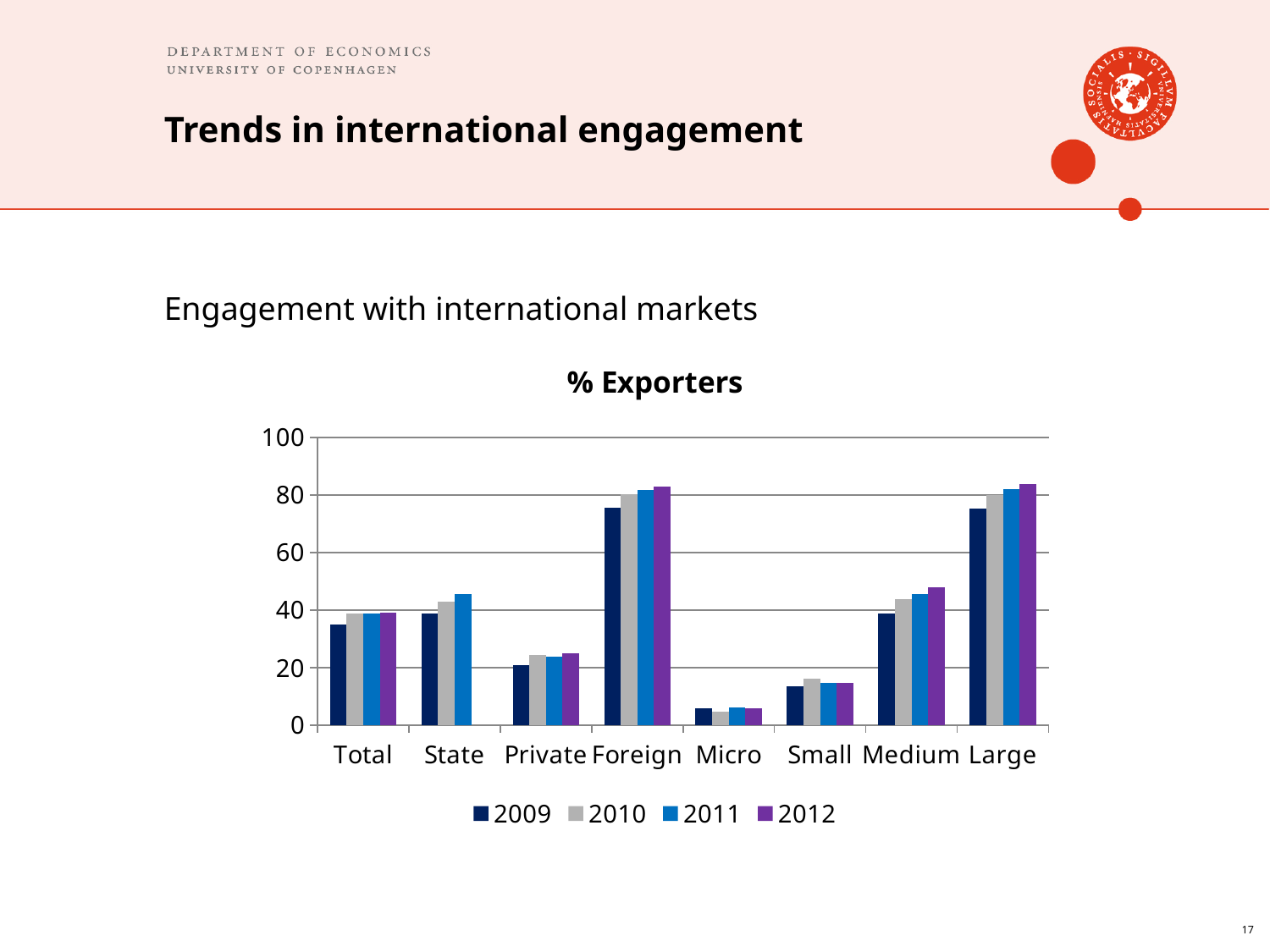
Which years are listed in the chart legend? 2009, 2010, 2011, 2012 Do the values for Medium rise or fall from 2009 to 2012? rise What is the title of the chart? % Exporters How many series does the legend of the % Exporters chart list? 4 Which is larger for 2009: the value for Foreign or the value for Private? Foreign Is the 2012 value for Medium greater or less than 40? greater Which category has the lowest values in the % Exporters chart? Micro How many categories are shown on the x axis of the % Exporters chart? 8 Is the 2009 value for Foreign greater or less than 60? greater Is the 2012 value for Micro greater or less than 20? less What kind of chart is shown on the slide? bar chart